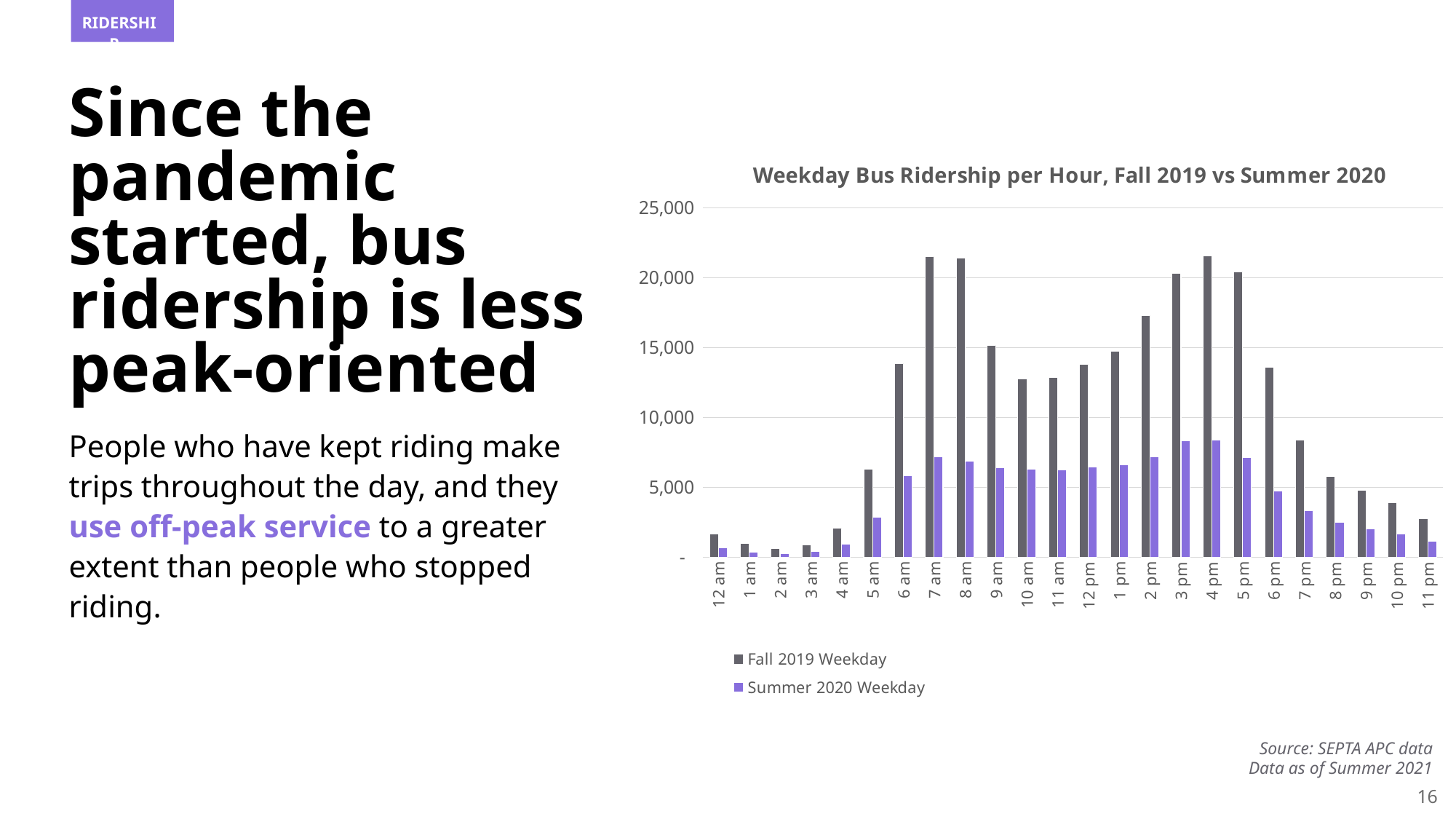
For Fall 2019 Weekday, which is larger: the value at 2 pm or the value at 6 pm? 2 pm Do the Fall 2019 Weekday values rise or fall from 5 pm to 11 pm? fall Is the Fall 2019 Weekday value at 7 am greater or less than 20,000? greater What kind of chart is shown on the slide? Bar chart How many series does the legend list? 2 What is the title of the chart? Weekday Bus Ridership per Hour, Fall 2019 vs Summer 2020 Is the Fall 2019 Weekday value at 5 am greater or less than 5,000? greater For Summer 2020 Weekday, which is larger: the value at 5 am or the value at 6 pm? 6 pm Is the Fall 2019 Weekday value at 7 pm greater or less than 10,000? less How many hourly categories are shown on the x axis? 24